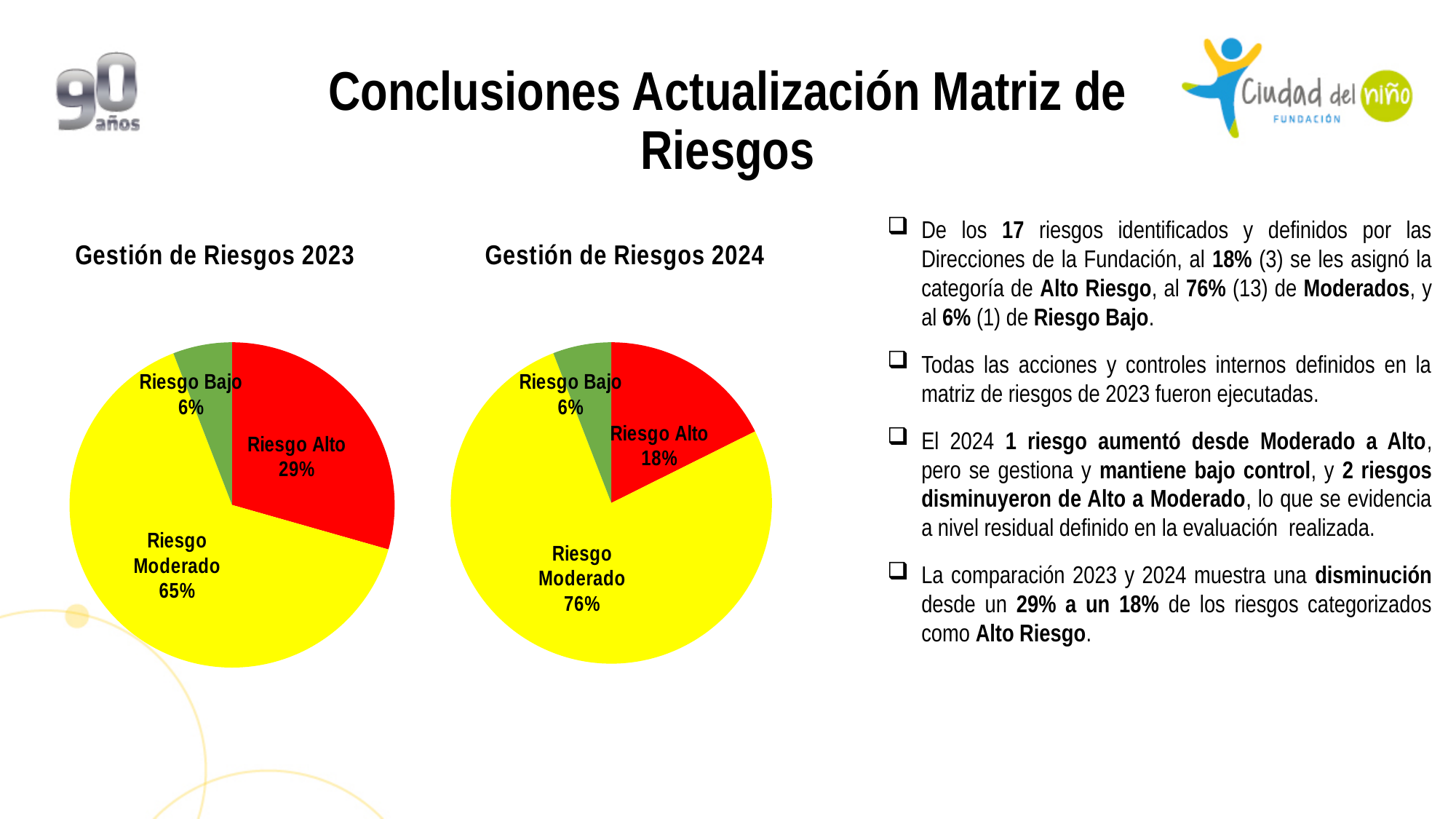
How many categories does the 'Gestión de Riesgos 2024' chart show? 3 In the 'Gestión de Riesgos 2024' chart, what is the value for Riesgo Alto? 18% In the 'Gestión de Riesgos 2023' chart, what colour is the Riesgo Alto slice? Red What kind of chart is 'Gestión de Riesgos 2023'? Pie chart In the 'Gestión de Riesgos 2023' chart, which category has the largest slice? Riesgo Moderado In the 'Gestión de Riesgos 2024' chart, what share of the pie is Riesgo Moderado? 76% In the 'Gestión de Riesgos 2024' chart, which is larger, Riesgo Alto or Riesgo Bajo? Riesgo Alto In the 'Gestión de Riesgos 2024' chart, which category has the smallest slice? Riesgo Bajo In the 'Gestión de Riesgos 2023' chart, what is the value for Riesgo Moderado? 65% In the 'Gestión de Riesgos 2024' chart, what is the value for Riesgo Bajo? 6% In the 'Gestión de Riesgos 2023' chart, what is the difference between Riesgo Moderado and Riesgo Alto? 36% In the 'Gestión de Riesgos 2023' chart, what share of the pie is Riesgo Alto? 29%